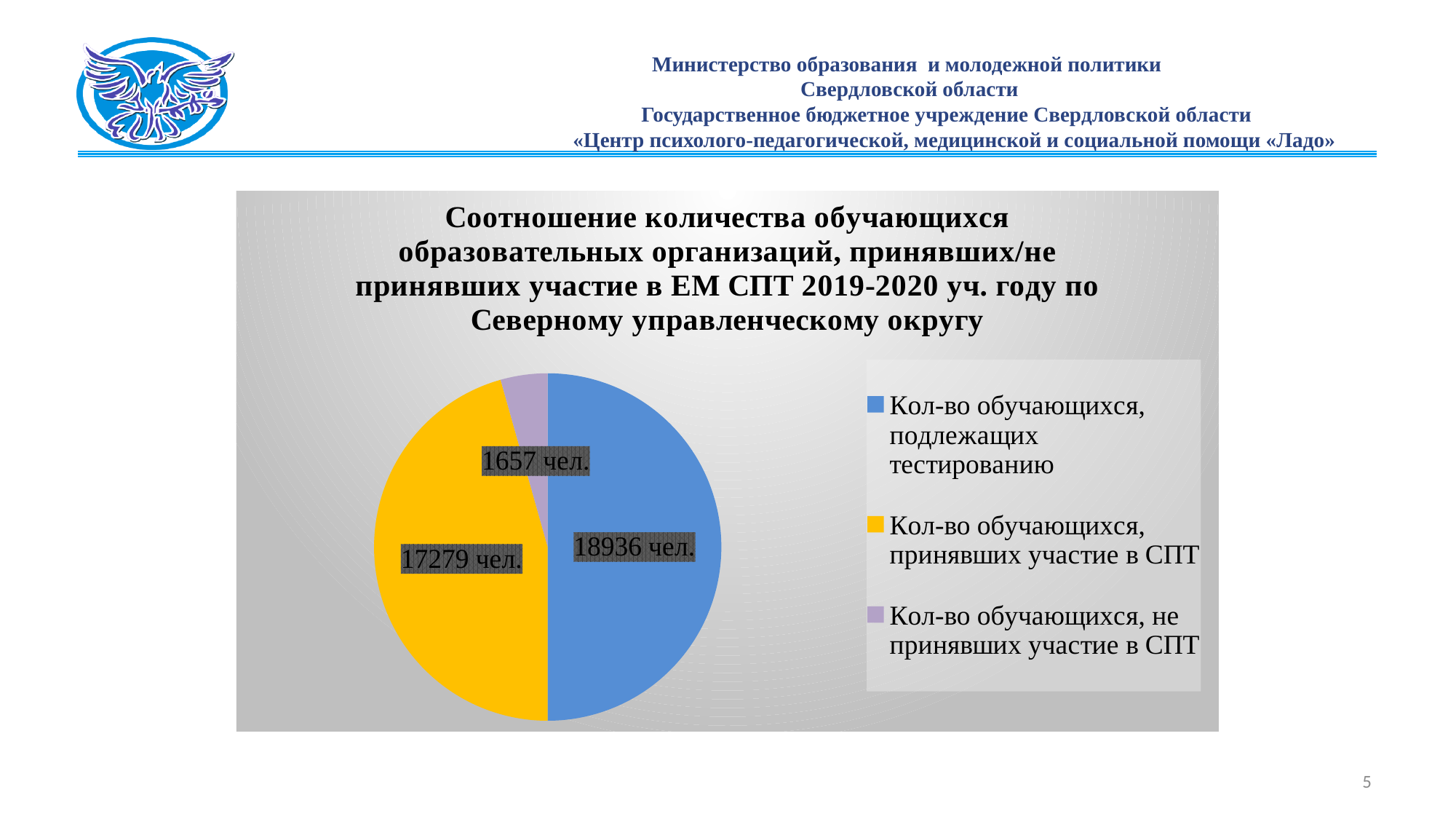
What share of the pie does the slice "Кол-во обучающихся, подлежащих тестированию" represent? 50% What type of chart is shown on the slide? Pie chart What is the value for "Кол-во обучающихся, подлежащих тестированию"? 18936 чел. What is the value for "Кол-во обучающихся, не принявших участие в СПТ"? 1657 чел. Which category has the largest slice of the pie? Кол-во обучающихся, подлежащих тестированию Which is larger: the number of students who took part in СПТ or the number who did not take part? Кол-во обучающихся, принявших участие в СПТ How many entries does the legend of the pie chart list? 3 Which category has the smallest slice of the pie? Кол-во обучающихся, не принявших участие в СПТ What is the difference between the number of students subject to testing and the number who took part in СПТ? 1657 How many slices does the pie chart have? 3 What is the value for "Кол-во обучающихся, принявших участие в СПТ"? 17279 чел. What colour is the slice for "Кол-во обучающихся, принявших участие в СПТ"? Yellow